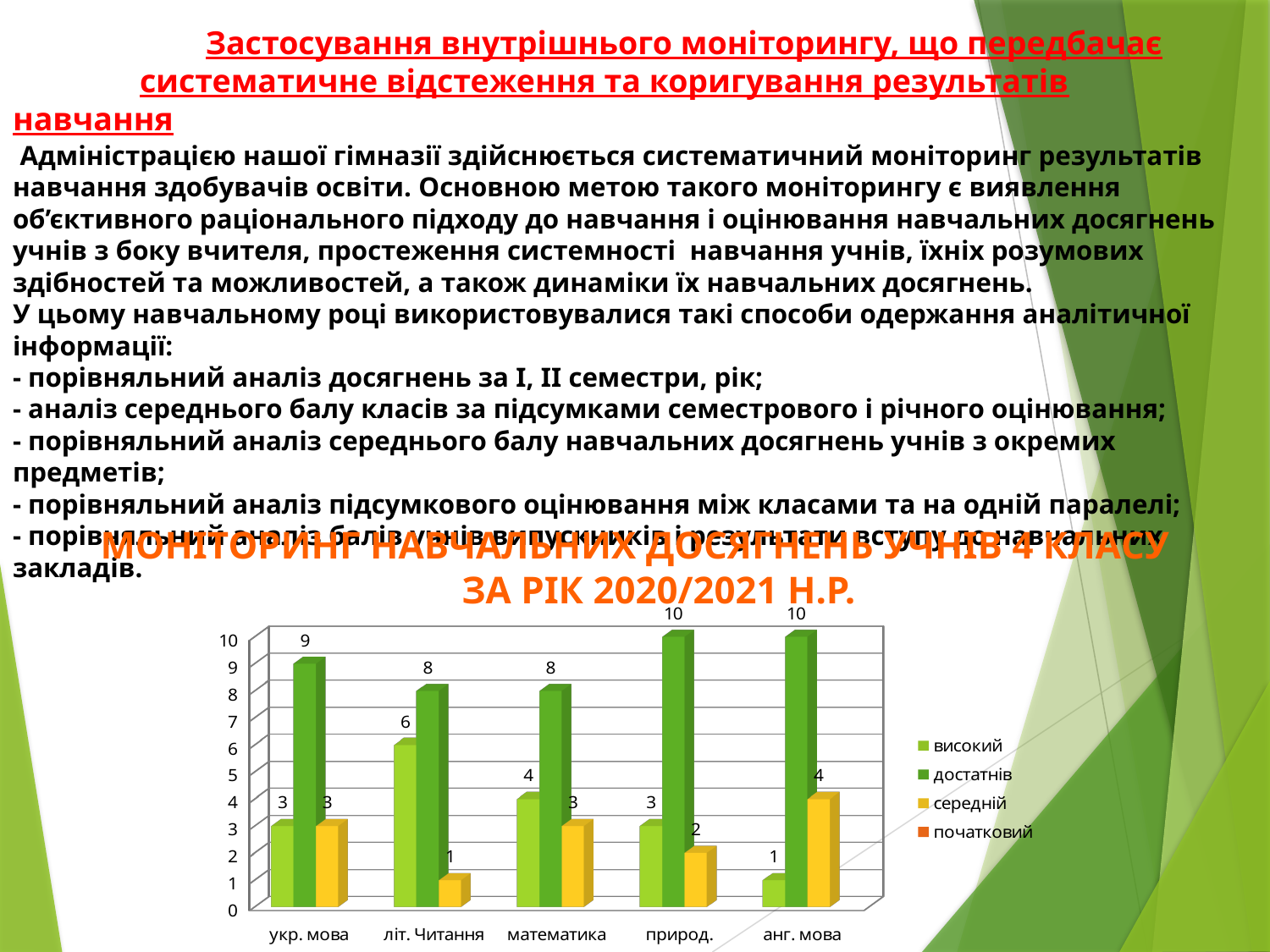
Which is larger: the високий value for математика or the високий value for укр. мова? математика What is the total of the високий, достатній and середній values for математика? 15 What is the difference between the достатній and високий values for природ.? 7 What is the value of the достатній series for укр. мова? 9 How many series does the legend list? 4 What kind of chart is shown on the slide? bar chart How many categories are shown on the x axis? 5 What is the value of the середній series for анг. мова? 4 What is the value of the високий series for літ. Читання? 6 What is the value of the високий series for анг. мова? 1 Which category has the highest value in the високий series? літ. Читання Which category has the lowest value in the середній series? літ. Читання